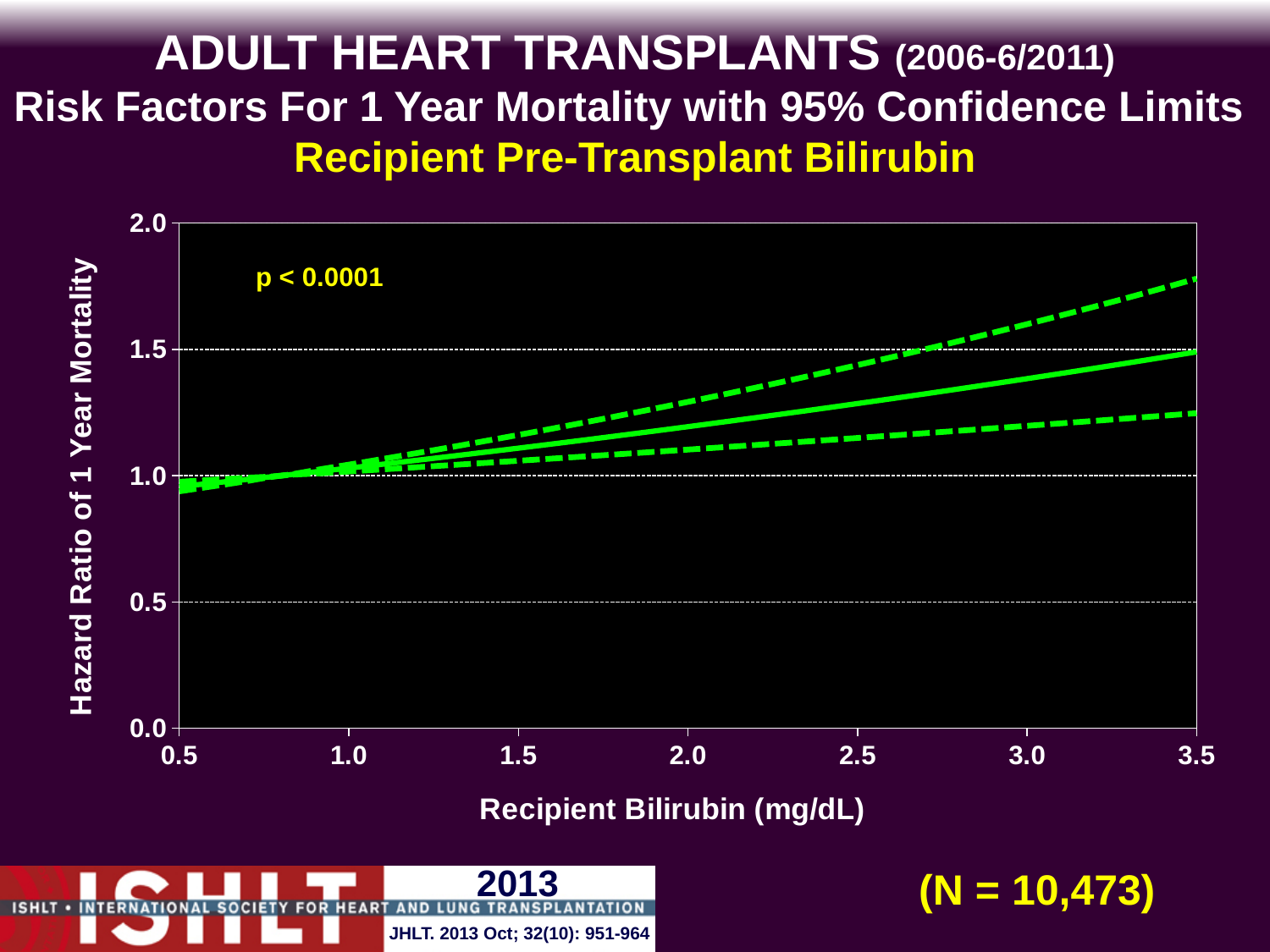
Is the upper 95% confidence limit (upper dashed line) at a recipient bilirubin of 3.0 mg/dL greater or less than 1.5? greater Is the lower 95% confidence limit (lower dashed line) at a recipient bilirubin of 3.5 mg/dL greater or less than 1.5? less Is the lower 95% confidence limit (lower dashed line) at a recipient bilirubin of 3.0 mg/dL greater or less than 1.0? greater Does the hazard ratio of 1 year mortality rise or fall as recipient bilirubin increases from 0.5 to 3.5 mg/dL? rise What p-value is printed on the chart? p < 0.0001 How many lines are plotted on the chart? 3 What is the label of the x axis? Recipient Bilirubin (mg/dL) What kind of chart is shown on the slide? line chart